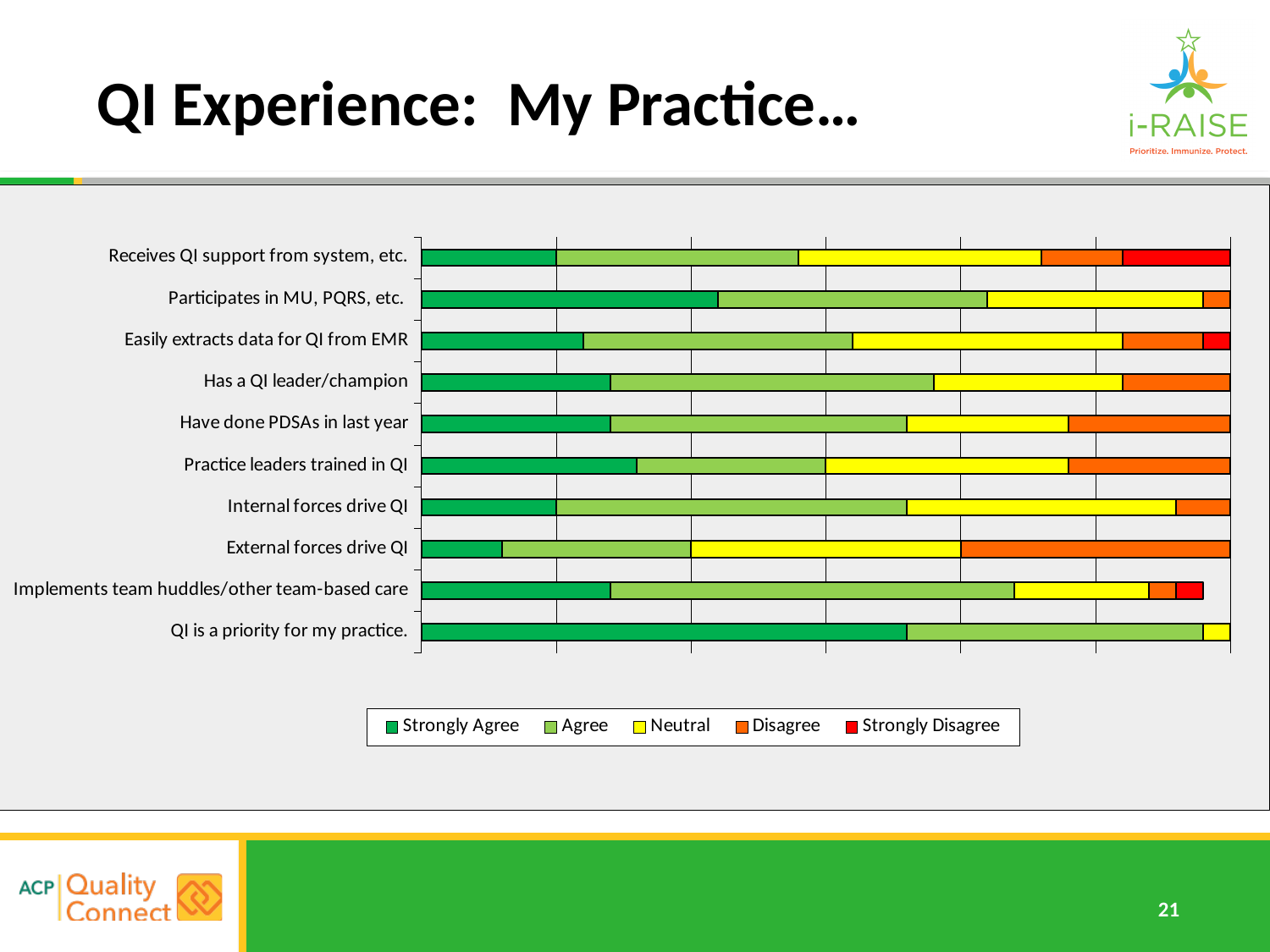
What kind of chart is shown on the slide? Stacked bar chart How many categories (statements) are plotted on the chart? 10 Which category has the largest Disagree segment? External forces drive QI Which category has the largest Strongly Agree segment? QI is a priority for my practice. What is the last entry listed in the legend? Strongly Disagree Which category has the largest Strongly Disagree segment? Receives QI support from system, etc. What colour represents the Neutral series in the legend? Yellow How many series does the legend list? 5 Which category has the smallest Strongly Agree segment? External forces drive QI Is the Neutral segment larger for 'External forces drive QI' or for 'QI is a priority for my practice.'? External forces drive QI Is the Strongly Agree segment larger for 'Participates in MU, PQRS, etc.' or for 'External forces drive QI'? Participates in MU, PQRS, etc.